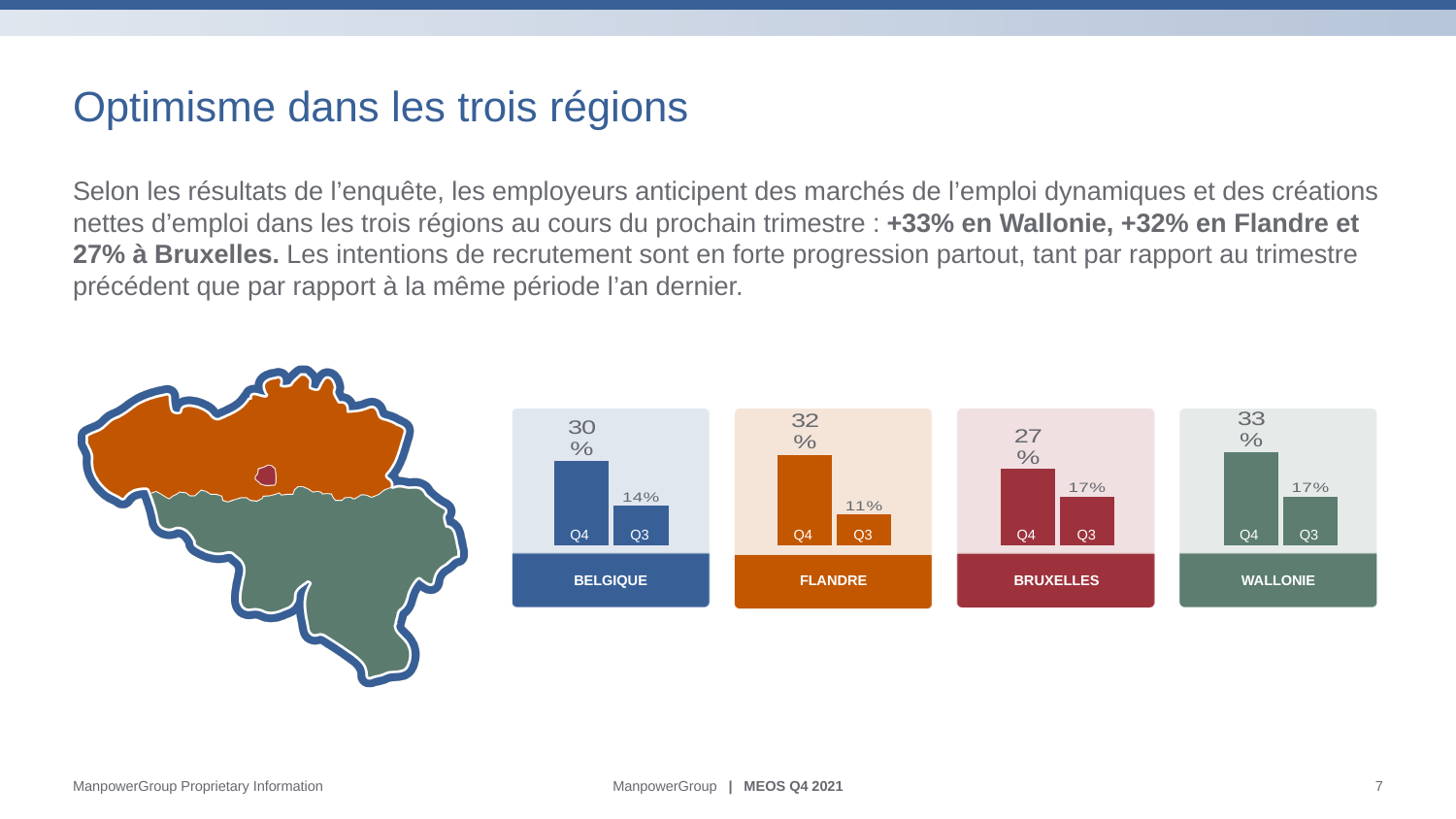
What kind of chart is used for the WALLONIE panel? Bar chart In the WALLONIE chart, what is the value for Q4? 33% In the BELGIQUE chart, what is the value for Q3? 14% In the BRUXELLES chart, which bar is higher, Q4 or Q3? Q4 How many regional bar charts are shown on the slide? 4 In the BRUXELLES chart, what is the value for Q4? 27% In the FLANDRE chart, what is the difference between the Q4 and Q3 values? 21% In the WALLONIE chart, what is the difference between the Q4 and Q3 values? 16% In the BELGIQUE chart, which quarter has the lowest value? Q3 How many bars are shown in the FLANDRE chart? 2 In the FLANDRE chart, what is the value for Q3? 11% In the BELGIQUE chart, what is the value for Q4? 30%